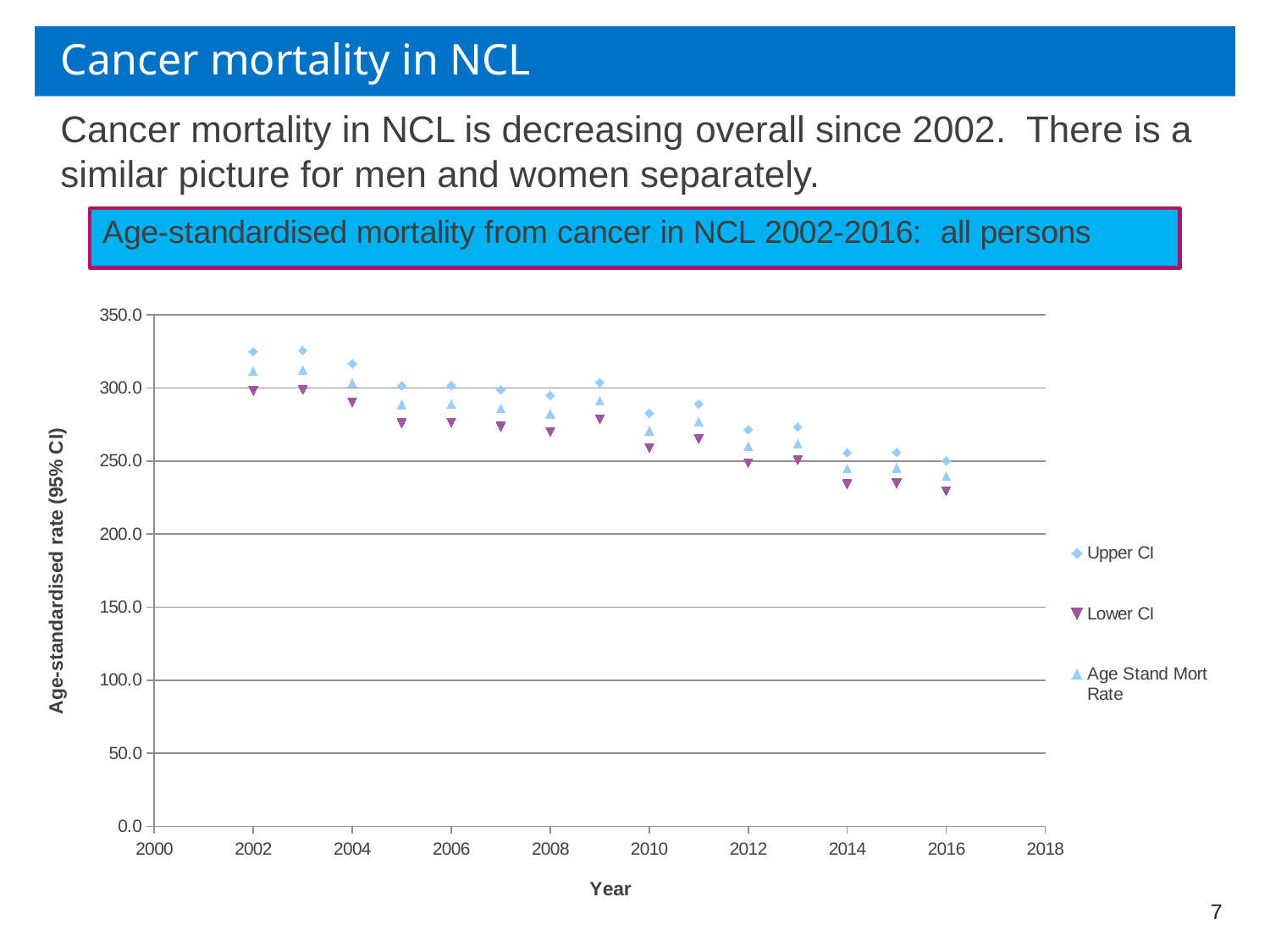
How many series does the legend list? 3 Is the Age Stand Mort Rate for 2002 greater or less than 300? greater Is the Upper CI value for 2002 greater or less than 300? greater Does the Age Stand Mort Rate rise or fall from 2002 to 2016? fall Which is larger, the Upper CI value for 2009 or for 2010? 2009 Which is larger, the Age Stand Mort Rate for 2002 or for 2016? 2002 Is the Lower CI value for 2005 greater or less than 300? less What kind of chart is shown on the slide? scatter chart What is the label of the vertical axis? Age-standardised rate (95% CI) What is the title of the chart? Age-standardised mortality from cancer in NCL 2002-2016: all persons How many years are plotted for the Age Stand Mort Rate series? 15